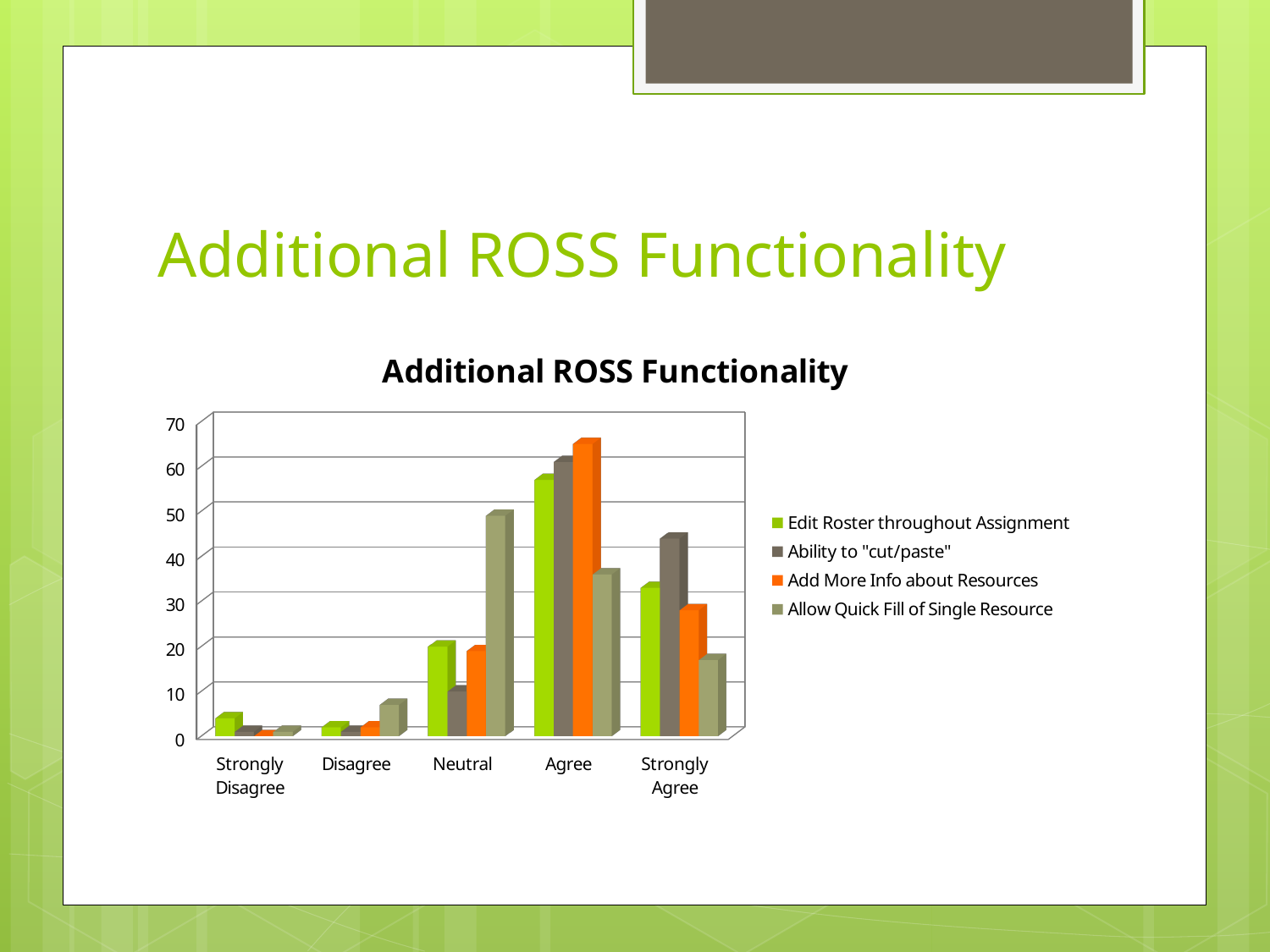
For the "Allow Quick Fill of Single Resource" series, which category has the highest value? Neutral What is the title of the chart? Additional ROSS Functionality Is the value for "Allow Quick Fill of Single Resource" at Neutral greater or less than 40? greater What colour represents the "Add More Info about Resources" series? orange Is the value for "Add More Info about Resources" at Agree greater or less than 60? greater How many response categories are shown on the x axis? 5 At Strongly Agree, which is larger: "Ability to "cut/paste"" or "Edit Roster throughout Assignment"? Ability to "cut/paste" At Neutral, which is larger: "Allow Quick Fill of Single Resource" or "Edit Roster throughout Assignment"? Allow Quick Fill of Single Resource How many series does the legend list? 4 Is the value for "Ability to "cut/paste"" at Neutral greater or less than 20? less For the "Add More Info about Resources" series, which category has the highest value? Agree What kind of chart is shown on the slide? bar chart